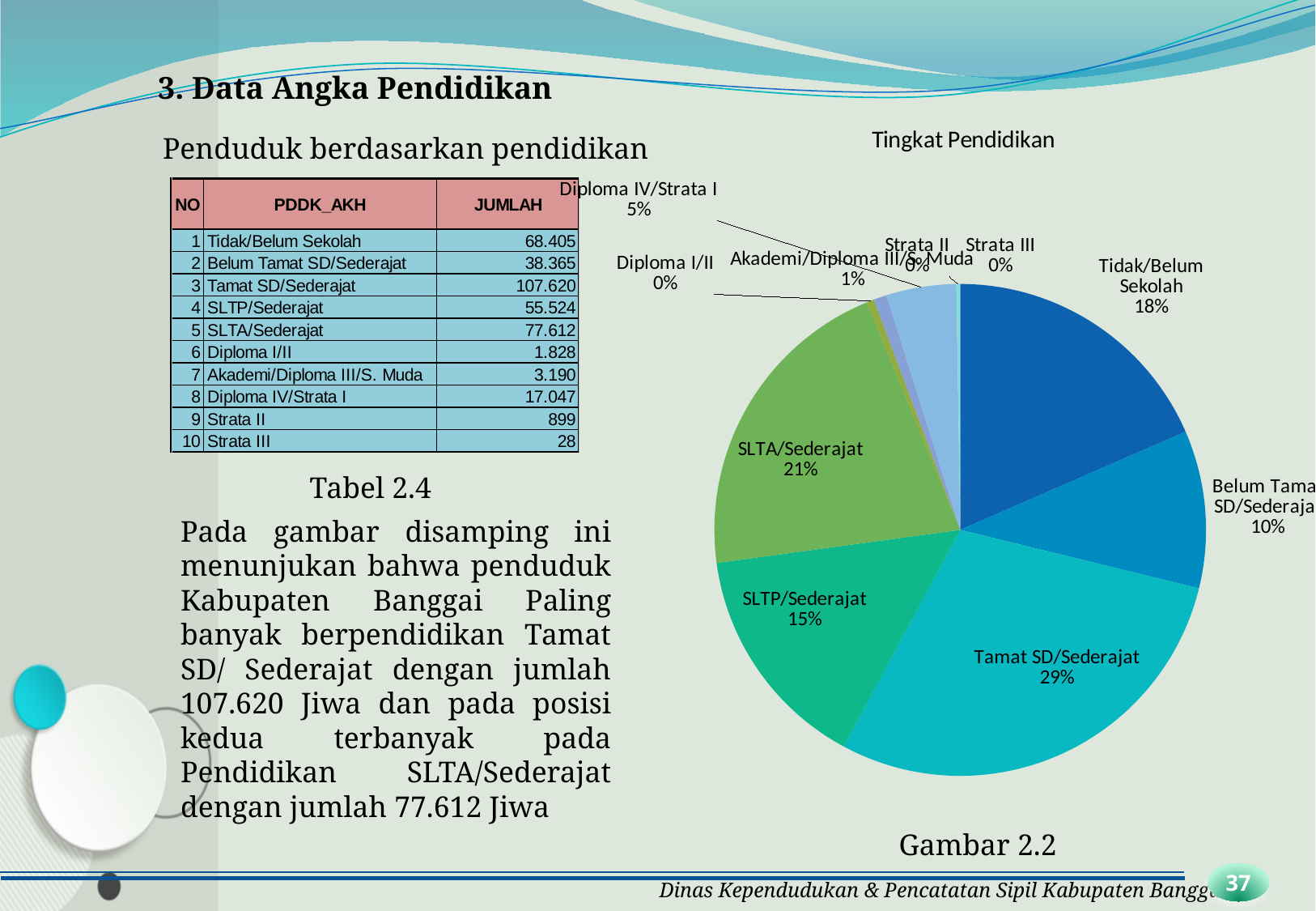
What share of the pie does SLTA/Sederajat represent? 21% What percentage is shown for Tidak/Belum Sekolah in the pie chart? 18% What percentage is shown for Belum Tamat SD/Sederajat in the pie chart? 10% Which category has the largest slice of the pie chart? Tamat SD/Sederajat What percentage is shown for SLTP/Sederajat in the pie chart? 15% What kind of chart is shown on the slide? pie chart What share of the pie does Tamat SD/Sederajat represent? 29% How many slices (categories) does the pie chart have? 10 What percentage is shown for Diploma IV/Strata I in the pie chart? 5% What is the title of the pie chart? Tingkat Pendidikan What is the difference in percentage points between Tamat SD/Sederajat and SLTA/Sederajat in the pie chart? 8% Which slice is larger in the pie chart, SLTA/Sederajat or SLTP/Sederajat? SLTA/Sederajat